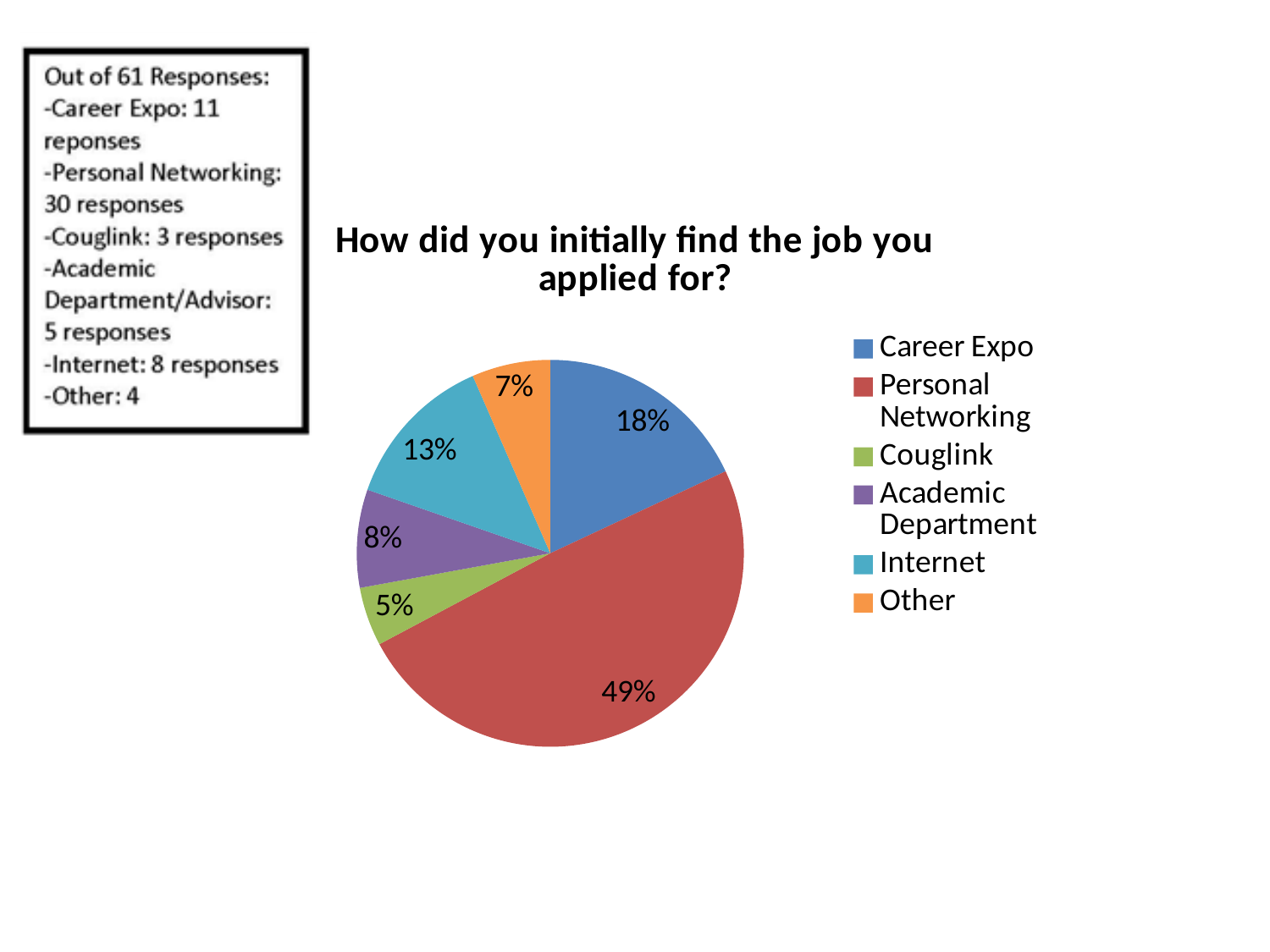
How many categories does the pie chart show? 6 What share of the pie does Personal Networking represent? 49% Which is larger, the share for Internet or the share for Academic Department? Internet What is the difference in percentage points between Personal Networking and Career Expo? 31 What colour is the Other slice in the pie chart? orange What share of the pie does Couglink represent? 5% What kind of chart is shown on the slide? pie chart Which category has the largest slice of the pie? Personal Networking What share of the pie does Career Expo represent? 18% What is the title of the chart? How did you initially find the job you applied for? Which category has the smallest slice of the pie? Couglink